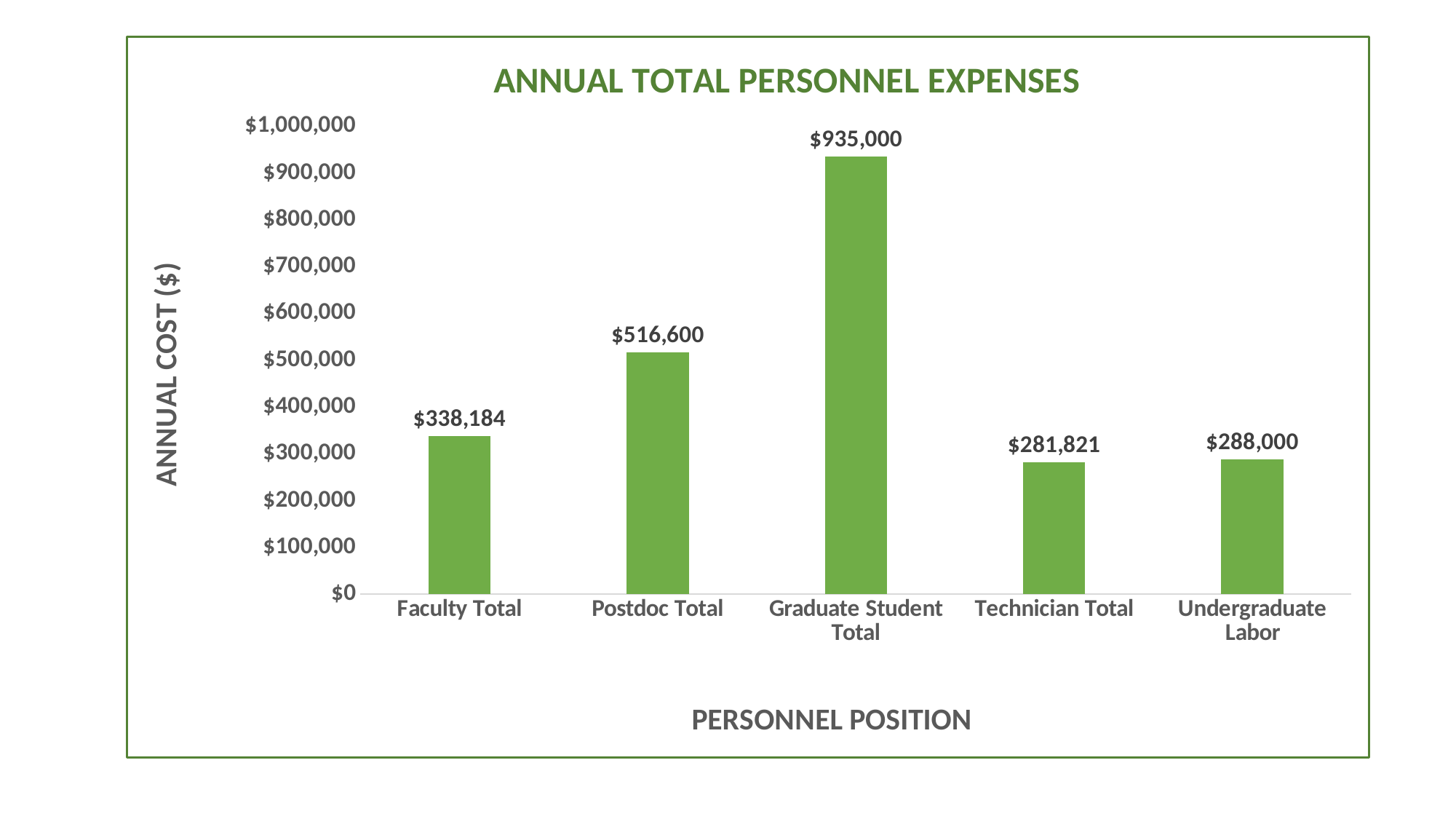
Is the value for Postdoc Total greater or less than $500,000? greater What type of chart is shown on the slide? Bar chart Which is larger, the Faculty Total expense or the Undergraduate Labor expense? Faculty Total What is the annual total personnel expense for Postdoc Total? $516,600 What is the annual total personnel expense for Faculty Total? $338,184 What is the difference between the Faculty Total and the Technician Total expenses? $56,363 Which personnel position has the highest annual total expense? Graduate Student Total What is the difference between the Graduate Student Total and the Postdoc Total expenses? $418,400 What is the annual total personnel expense for Technician Total? $281,821 What is the annual total personnel expense for Undergraduate Labor? $288,000 How many personnel positions are shown on the chart? 5 Which personnel position has the lowest annual total expense? Technician Total